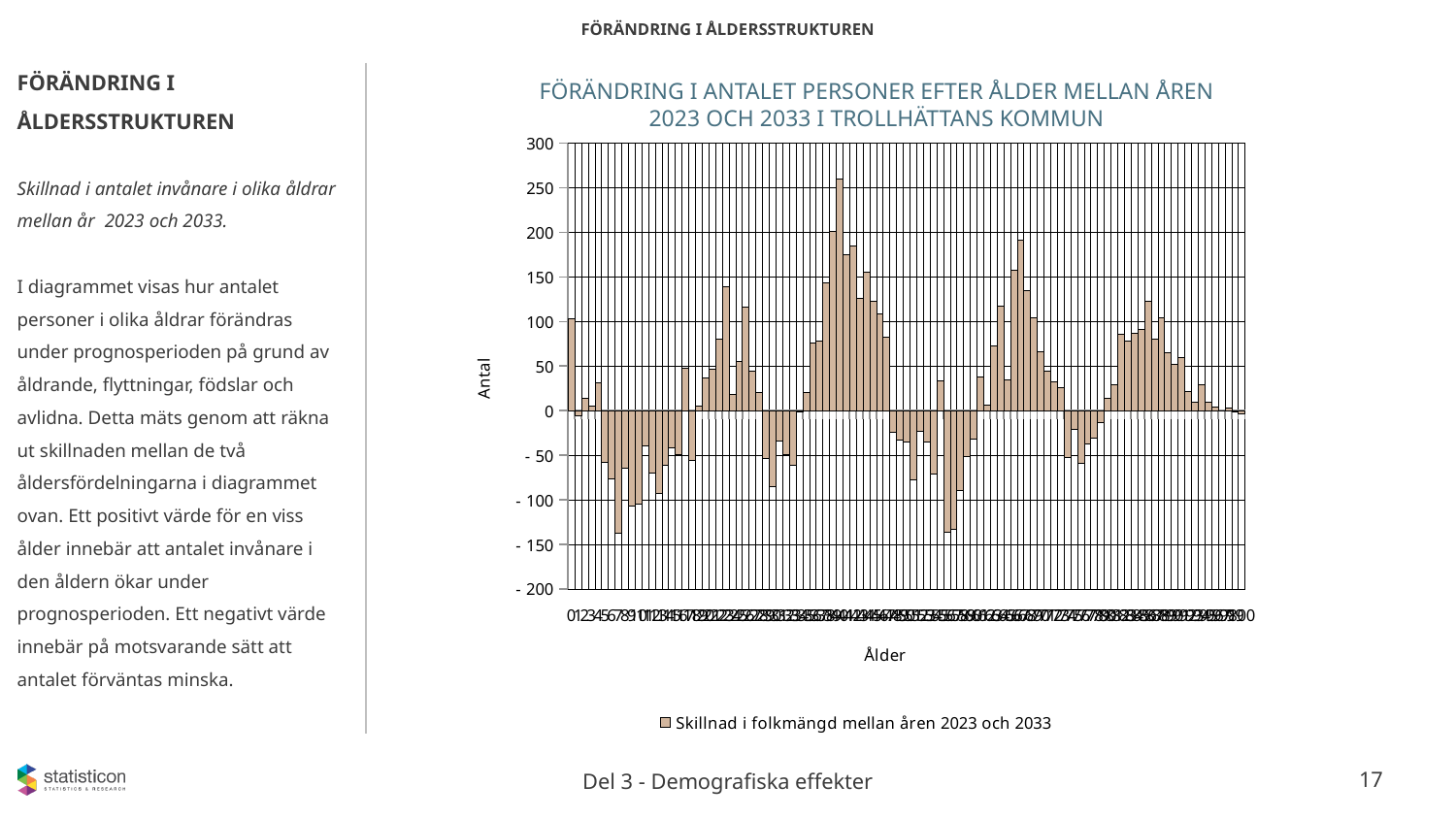
What kind of chart is shown on the slide? Bar chart Is the value for age 100 greater or less than 50? less What is the title of the chart? FÖRÄNDRING I ANTALET PERSONER EFTER ÅLDER MELLAN ÅREN 2023 OCH 2033 I TROLLHÄTTANS KOMMUN Is the value for age 0 greater or less than 50? greater What is the legend entry of the series in the chart? Skillnad i folkmängd mellan åren 2023 och 2033 Is the lowest value shown in the chart greater or less than -100? less How many series does the legend list? 1